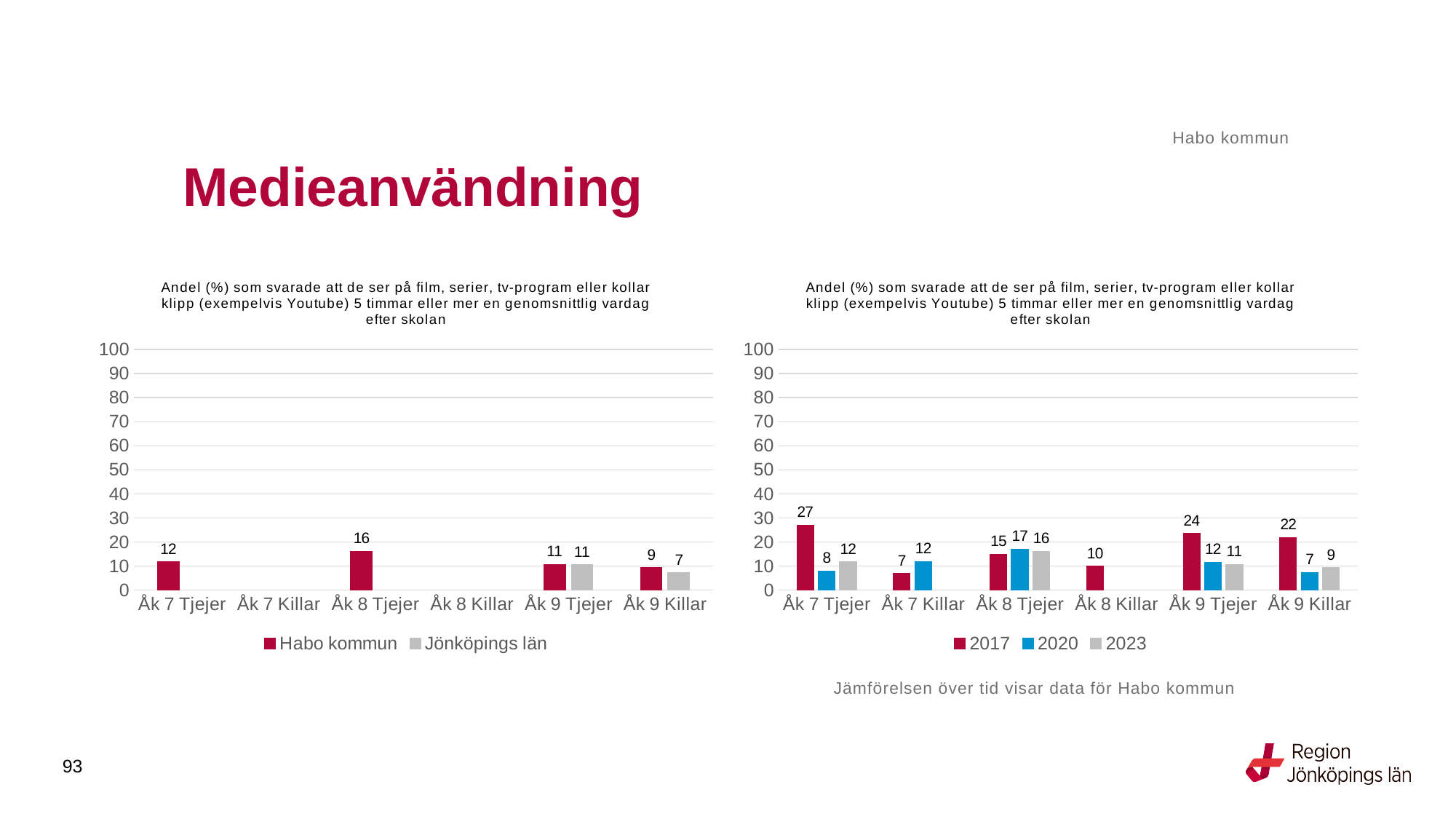
In the right chart, what is the 2020 value for Åk 8 Tjejer? 17 In the right chart, which is larger for Åk 9 Tjejer: the 2020 value or the 2023 value? 2020 In the left chart, what is the difference between Habo kommun and Jönköpings län for Åk 9 Killar? 2 In the right chart, what is the 2017 value for Åk 7 Tjejer? 27 In the left chart, how many series does the legend list? 2 In the right chart, what is the difference between the 2017 and 2023 values for Åk 9 Killar? 13 In the left chart, what is the value for Habo kommun for Åk 8 Tjejer? 16 In the left chart, which category has the highest Habo kommun value? Åk 8 Tjejer In the left chart, what is the value for Jönköpings län for Åk 9 Killar? 7 In the right chart, which category has the lowest 2017 value? Åk 7 Killar What kind of chart is the right chart? Bar chart In the right chart, how many series does the legend list? 3